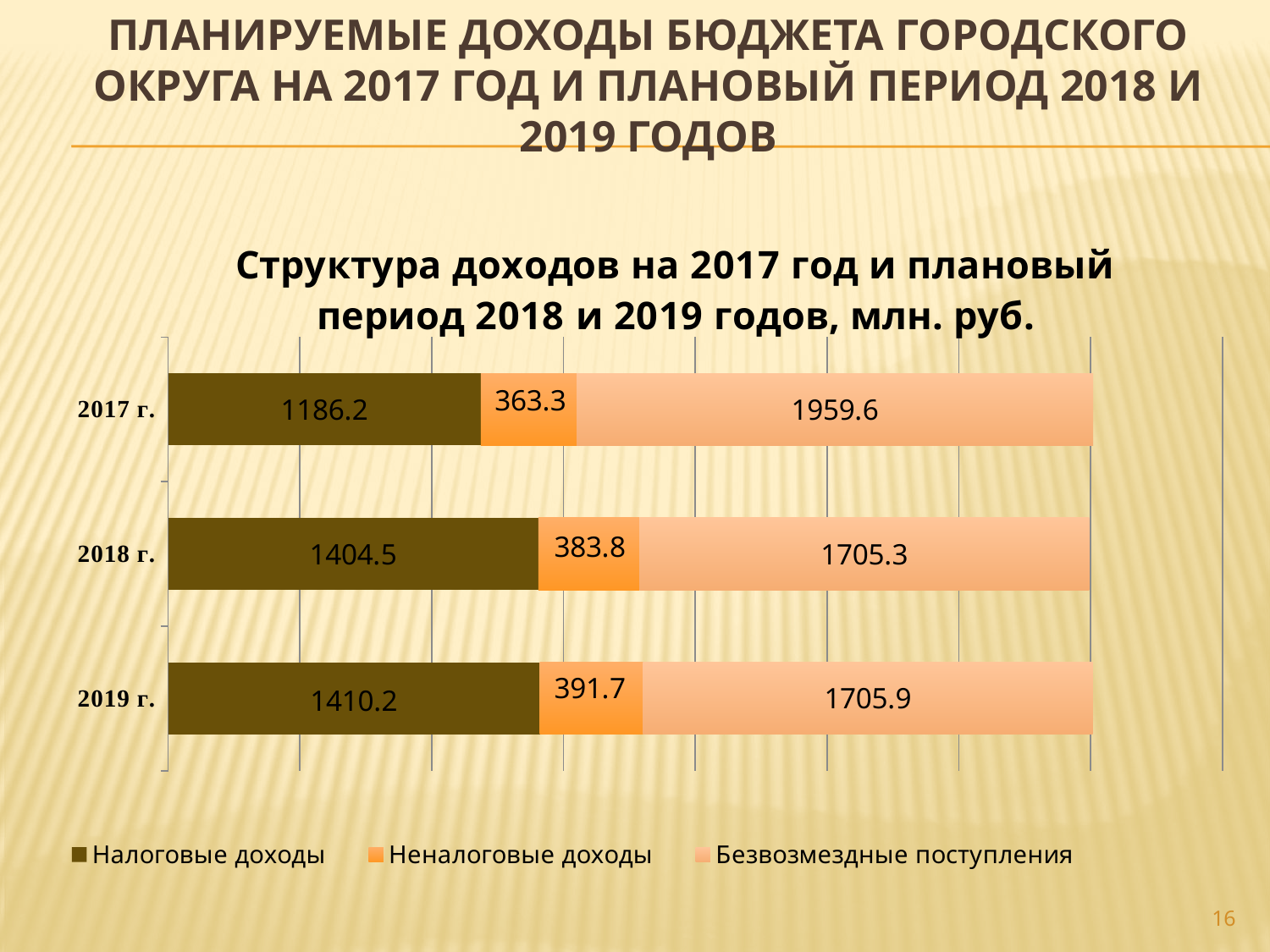
How many series does the legend list? 3 How many years (categories) are shown in the chart? 3 In which year are Неналоговые доходы the lowest? 2017 г. What is the value of Налоговые доходы for 2017 г.? 1186.2 What is the difference between Налоговые доходы in 2018 г. and 2017 г.? 218.3 What is the value of Безвозмездные поступления for 2018 г.? 1705.3 Do Неналоговые доходы rise or fall from 2017 г. to 2019 г.? Rise What is the total of the stacked bar for 2017 г.? 3509.1 What is the value of Неналоговые доходы for 2019 г.? 391.7 In which year are Налоговые доходы the highest? 2019 г. Which is larger: Безвозмездные поступления in 2017 г. or in 2019 г.? 2017 г. What type of chart is shown on the slide? Stacked bar chart